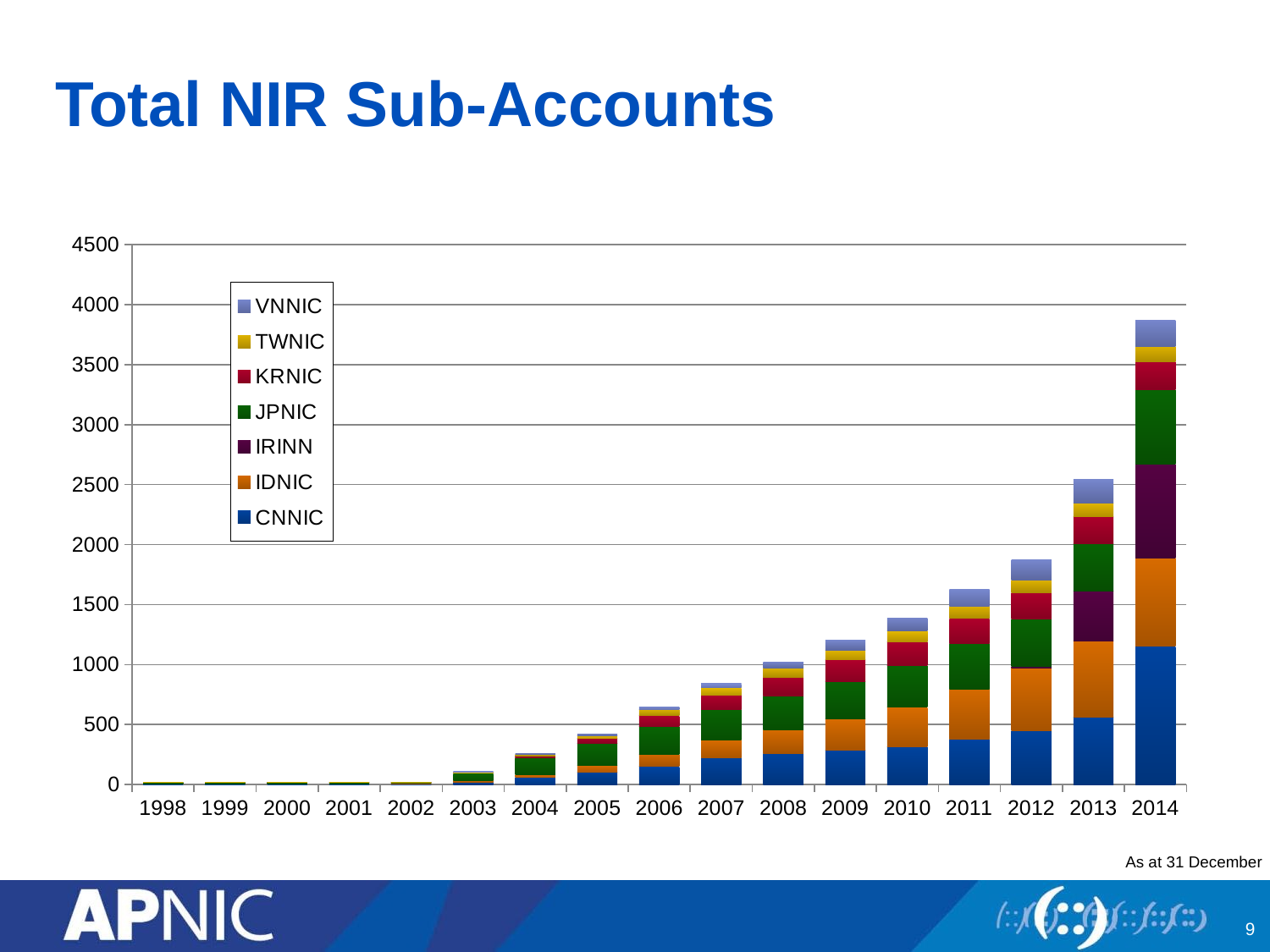
What kind of chart is shown on the slide? stacked bar chart What is the title of the chart on the slide? Total NIR Sub-Accounts Is the total for 2012 greater or less than 2000? less Is the total for 2009 greater or less than 1000? greater Which year has the highest total NIR sub-accounts? 2014 Is the total for 2010 greater or less than 1500? less How many years are shown along the x axis of the chart? 17 Which year has the larger total, 2013 or 2014? 2014 How many series does the chart's legend list? 7 Do the total NIR sub-accounts rise or fall from 1998 to 2014? rise